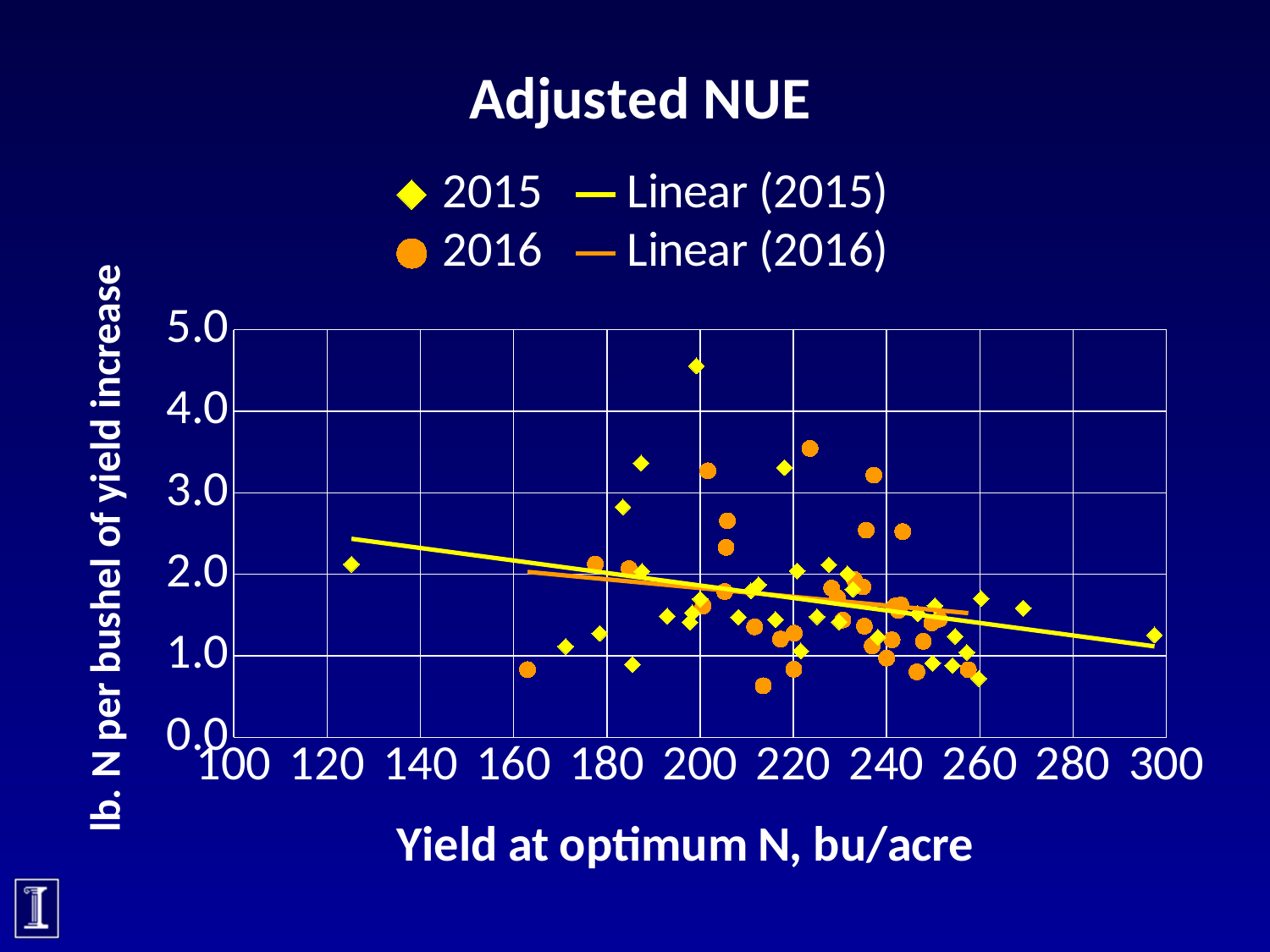
How many entries does the chart legend list? 4 What is the title of the chart? Adjusted NUE Does the Linear (2015) trendline rise or fall as yield increases along the x axis? fall Is the leftmost 2016 point (near 160 bu/acre) greater or less than 1.0 lb. N per bushel? less Which marker shape and colour represent the 2016 series? orange circles Is the highest 2016 point greater or less than 4.0 lb. N per bushel? less Is the leftmost 2015 point (near 125 bu/acre) greater or less than 2.0 lb. N per bushel? greater What kind of chart is shown on the slide? scatter chart Which series contains the single highest point on the chart, 2015 or 2016? 2015 How many data series (excluding the linear trendlines) are plotted? 2 Does the Linear (2016) trendline rise or fall as yield increases along the x axis? fall